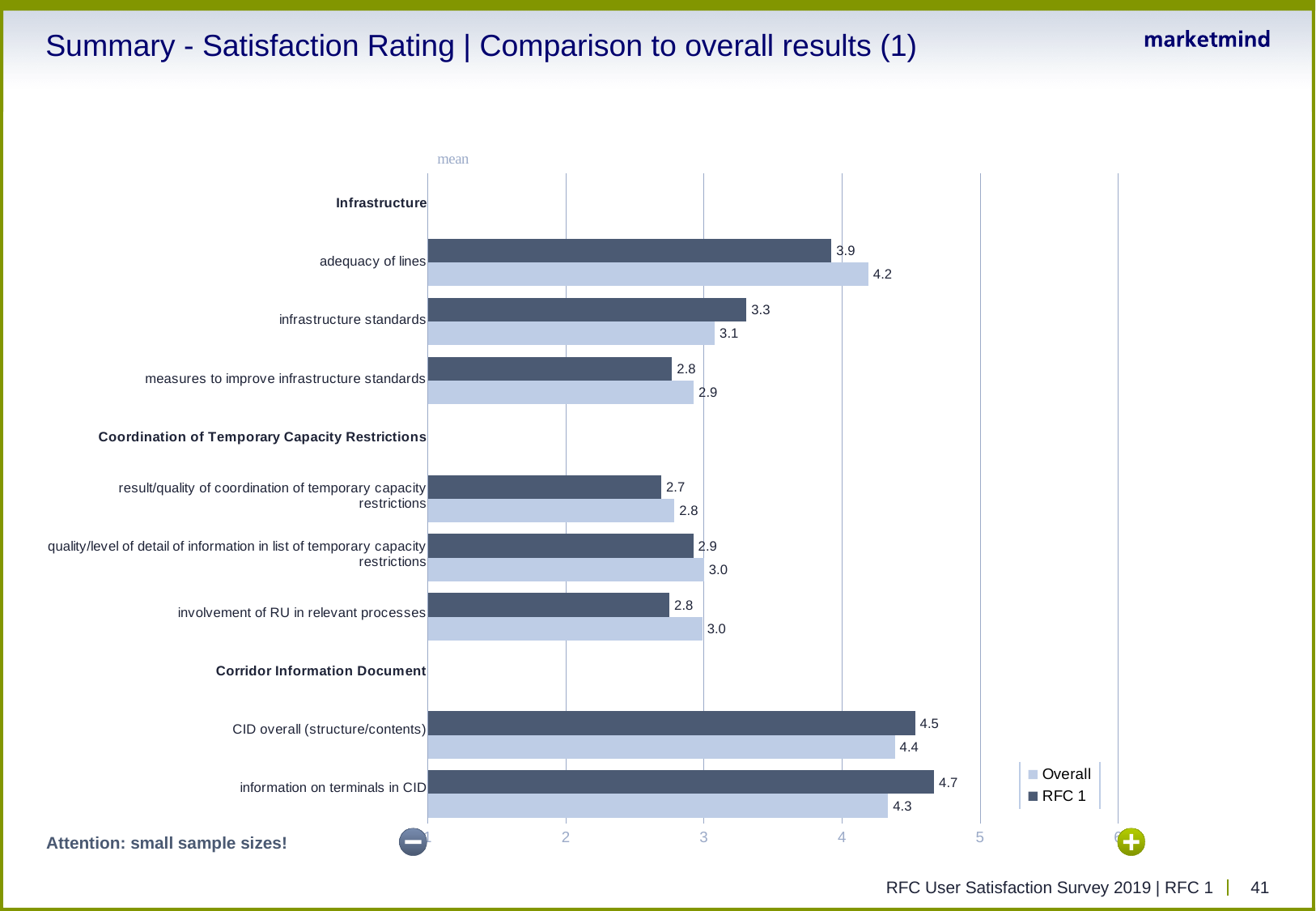
Which item has the highest RFC 1 value? information on terminals in CID What is the Overall value for involvement of RU in relevant processes? 3.0 For infrastructure standards, which is larger: the RFC 1 value or the Overall value? RFC 1 What is the Overall value for adequacy of lines? 4.2 Which series is shown in the darker colour according to the legend? RFC 1 What is the RFC 1 value for adequacy of lines? 3.9 Which item has the lowest RFC 1 value? result/quality of coordination of temporary capacity restrictions Is the Overall value for CID overall (structure/contents) greater or less than 4? greater How many series does the legend list? 2 What kind of chart is shown on the slide? bar chart What is the RFC 1 value for information on terminals in CID? 4.7 What is the difference between the RFC 1 and Overall values for information on terminals in CID? 0.4